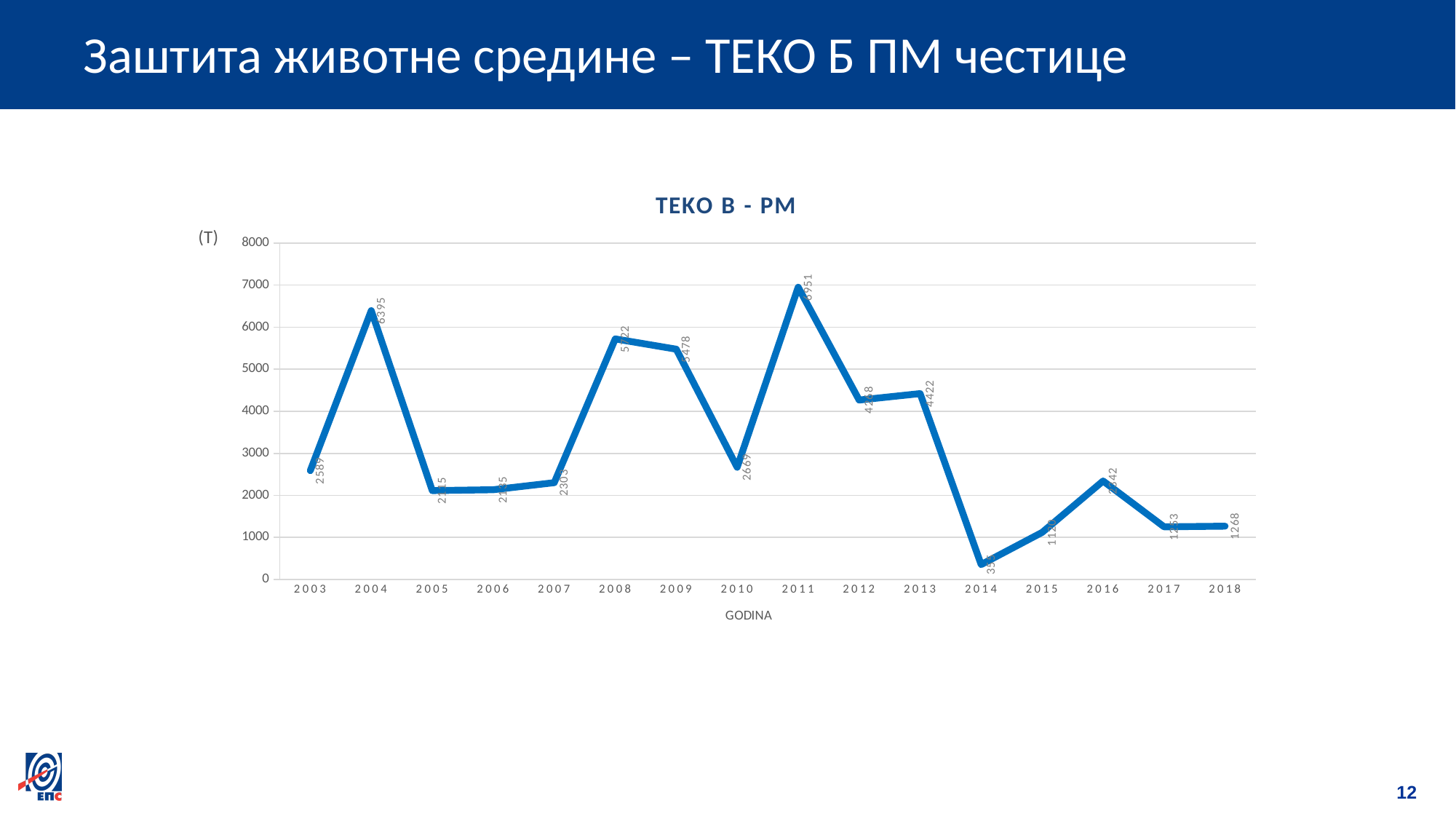
What kind of chart is shown? line chart What is the value for 2004? 6395 How many years are plotted on the x axis? 16 Is the value for 2014 greater or less than 1000? less What is the value for 2003? 2589 Which is larger, the value for 2004 or the value for 2013? 2004 What is the value for 2013? 4422 Which year has the lowest value? 2014 What is the value for 2018? 1268 Which year has the highest value? 2011 What is the value for 2007? 2303 What is the difference between the values for 2004 and 2003? 3806